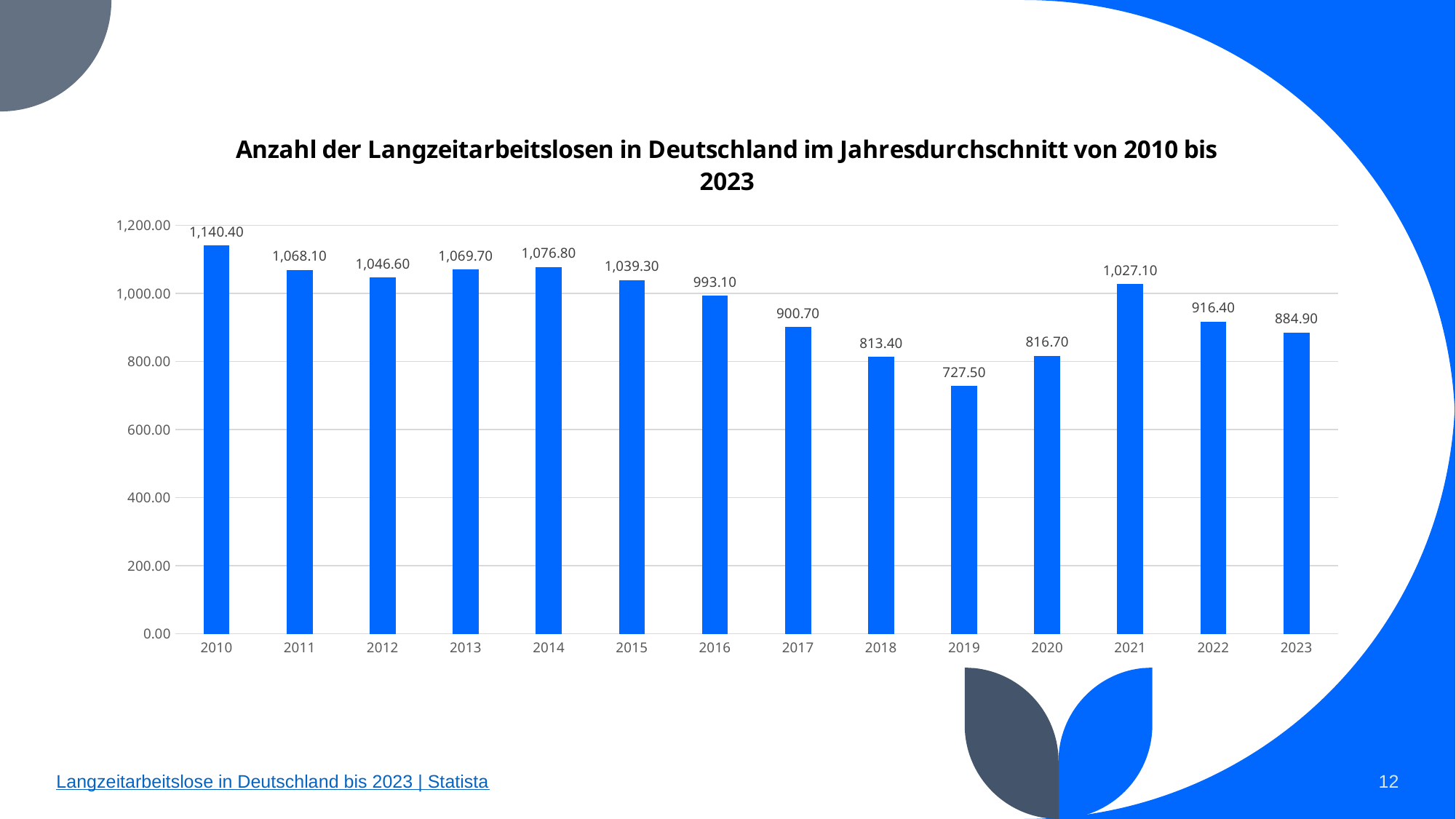
What is the value for 2023? 884.90 What is the value for 2019? 727.50 What is the difference between the values for 2021 and 2020? 210.40 What is the title of the chart? Anzahl der Langzeitarbeitslosen in Deutschland im Jahresdurchschnitt von 2010 bis 2023 What is the value for 2010? 1,140.40 How many years are shown on the x axis? 14 What is the difference between the values for 2010 and 2019? 412.90 Which year has the lowest value? 2019 Which is larger, the value for 2014 or the value for 2015? 2014 What is the value for 2021? 1,027.10 Which year has the highest value? 2010 What kind of chart is shown on the slide? Bar chart